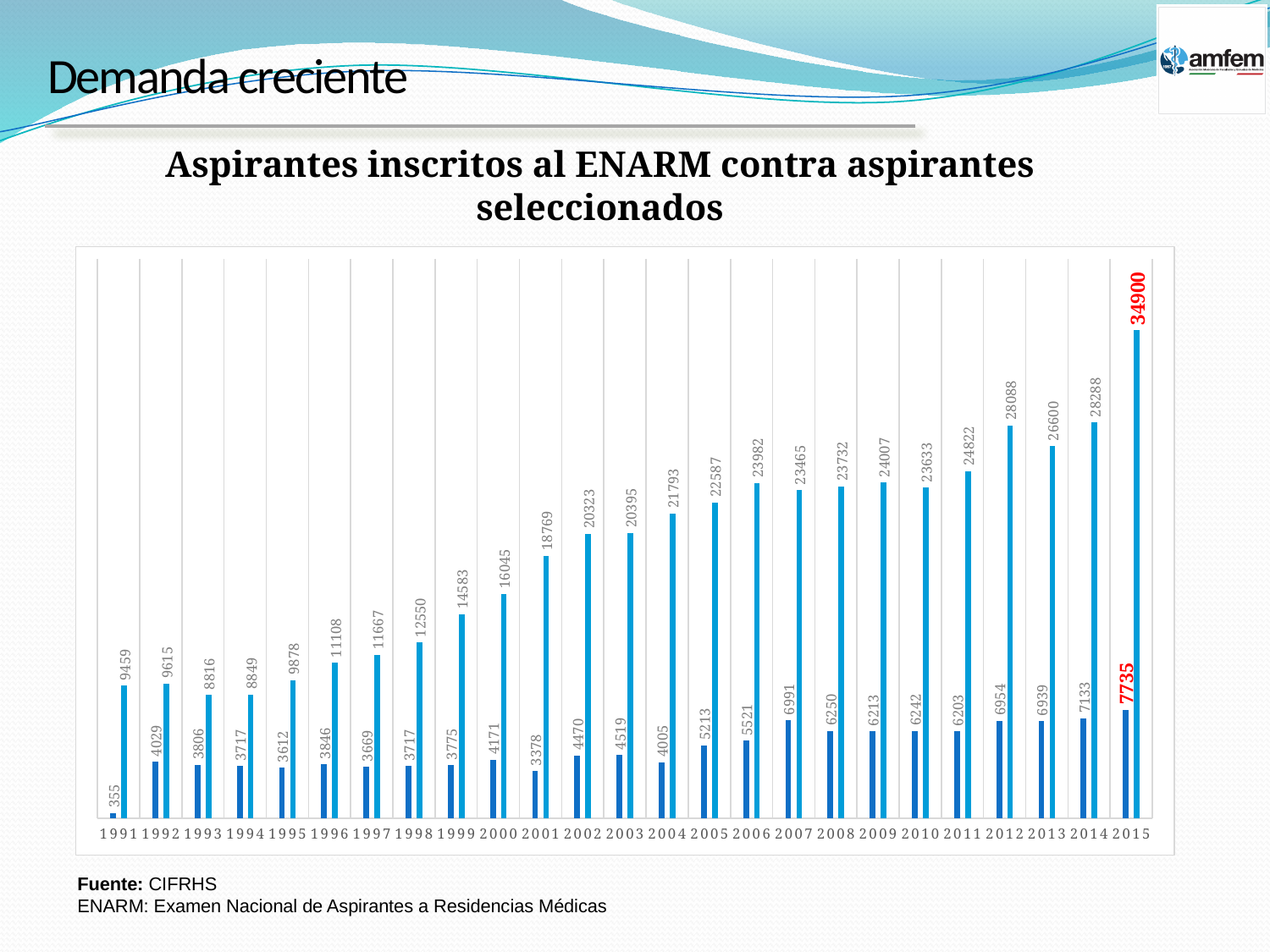
Which year has the highest value among the taller (light blue) bars? 2015 What is the value of the taller (light blue) bar for 2001? 18769 Do the values of the taller (light blue) bars generally rise or fall from 1991 to 2015? rise What is the difference between the taller (light blue) bar and the shorter (dark blue) bar for 2015? 27165 Which year has the larger value for the taller (light blue) bar, 2012 or 2013? 2012 What kind of chart is shown on the slide? bar chart How many years are shown along the x axis of the chart? 25 By how much did the taller (light blue) bar increase from 2014 to 2015? 6612 Which year has the lowest value among the shorter (dark blue) bars? 1991 What is the value of the taller (light blue) bar for 2015? 34900 What is the value of the shorter (dark blue) bar for 2015? 7735 What is the title of the chart? Aspirantes inscritos al ENARM contra aspirantes seleccionados